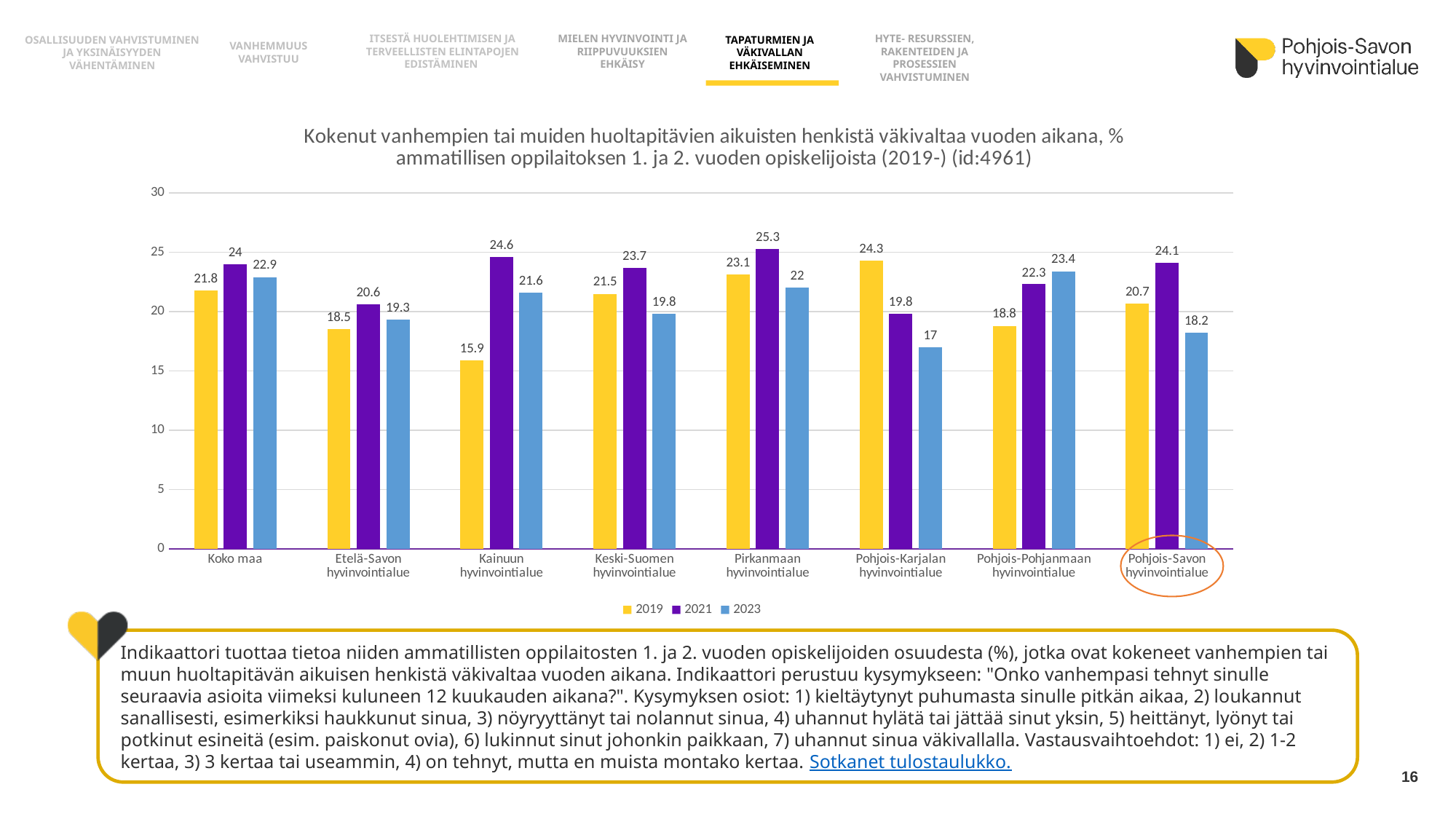
Which is larger for Pohjois-Pohjanmaan hyvinvointialue: the 2019 value or the 2023 value? 2023 How many regions (categories) are shown on the x axis? 8 Which region has the lowest value in the 2019 series? Kainuun hyvinvointialue Which region has the lowest value in the 2023 series? Pohjois-Karjalan hyvinvointialue What is the value for Kainuun hyvinvointialue in 2019? 15.9 What is the value for Pohjois-Savon hyvinvointialue in 2023? 18.2 Which region has the highest value in the 2021 series? Pirkanmaan hyvinvointialue What kind of chart is shown on the slide? Bar chart How many series does the legend list? 3 What is the difference between the 2021 and 2023 values for Pohjois-Savon hyvinvointialue? 5.9 For Pohjois-Karjalan hyvinvointialue, do the values rise or fall from 2019 to 2023? Fall What is the 2021 value for Koko maa? 24